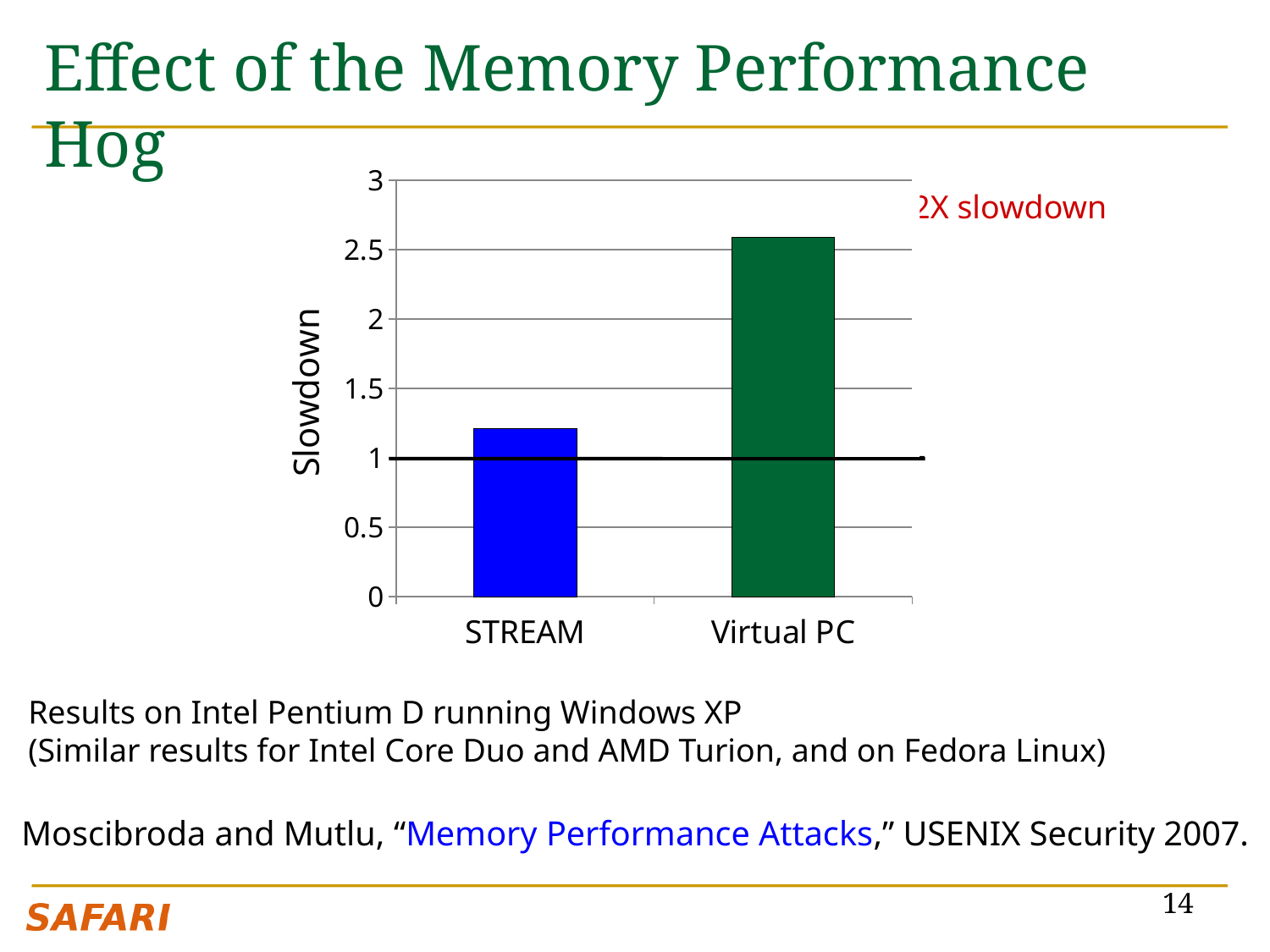
Is the slowdown value for STREAM greater or less than 1.5? less Is the slowdown value for STREAM greater or less than 1? greater Is the slowdown value for Virtual PC greater or less than 3? less What is the label of the y axis of the chart? Slowdown Which category has the lowest slowdown in the chart? STREAM Which has a larger slowdown, STREAM or Virtual PC? Virtual PC How many categories are plotted on the x axis of the chart? 2 What is the highest tick value shown on the y axis of the chart? 3 Which category has the highest slowdown in the chart? Virtual PC What kind of chart is shown on the slide? bar chart